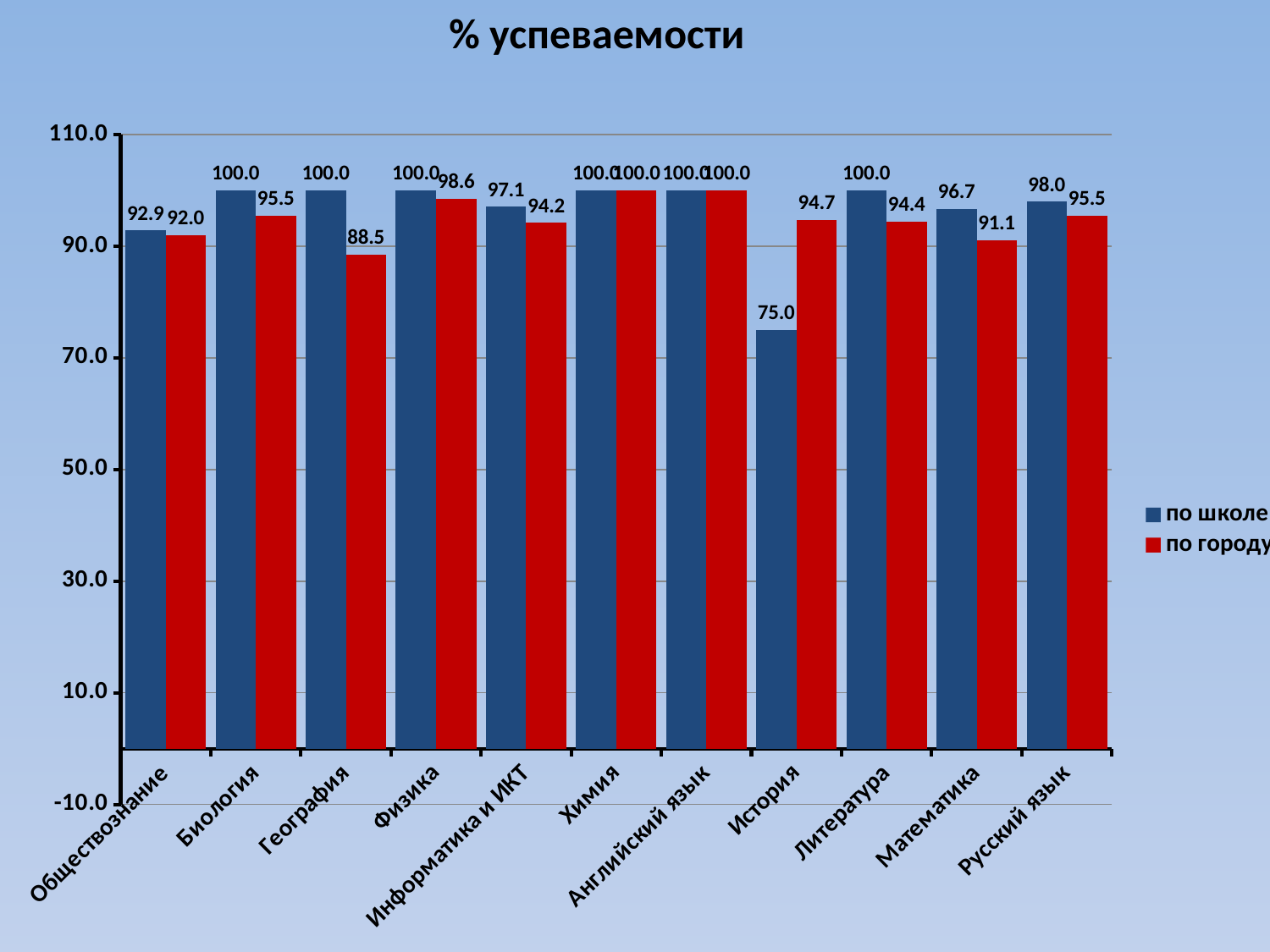
What is the value for История in the по школе series? 75.0 What is the difference between the по школе and по городу values for География? 11.5 How many series does the legend list? 2 What is the difference between the по школе and по городу values for История? 19.7 What is the value for География in the по городу series? 88.5 Which is larger for Русский язык: the по школе value or the по городу value? по школе Which category has the lowest value in the по школе series? История Which category has the lowest value in the по городу series? География What kind of chart is shown on the slide? bar chart How many categories are shown on the x axis? 11 What is the value for Математика in the по школе series? 96.7 What is the title of the chart? % успеваемости